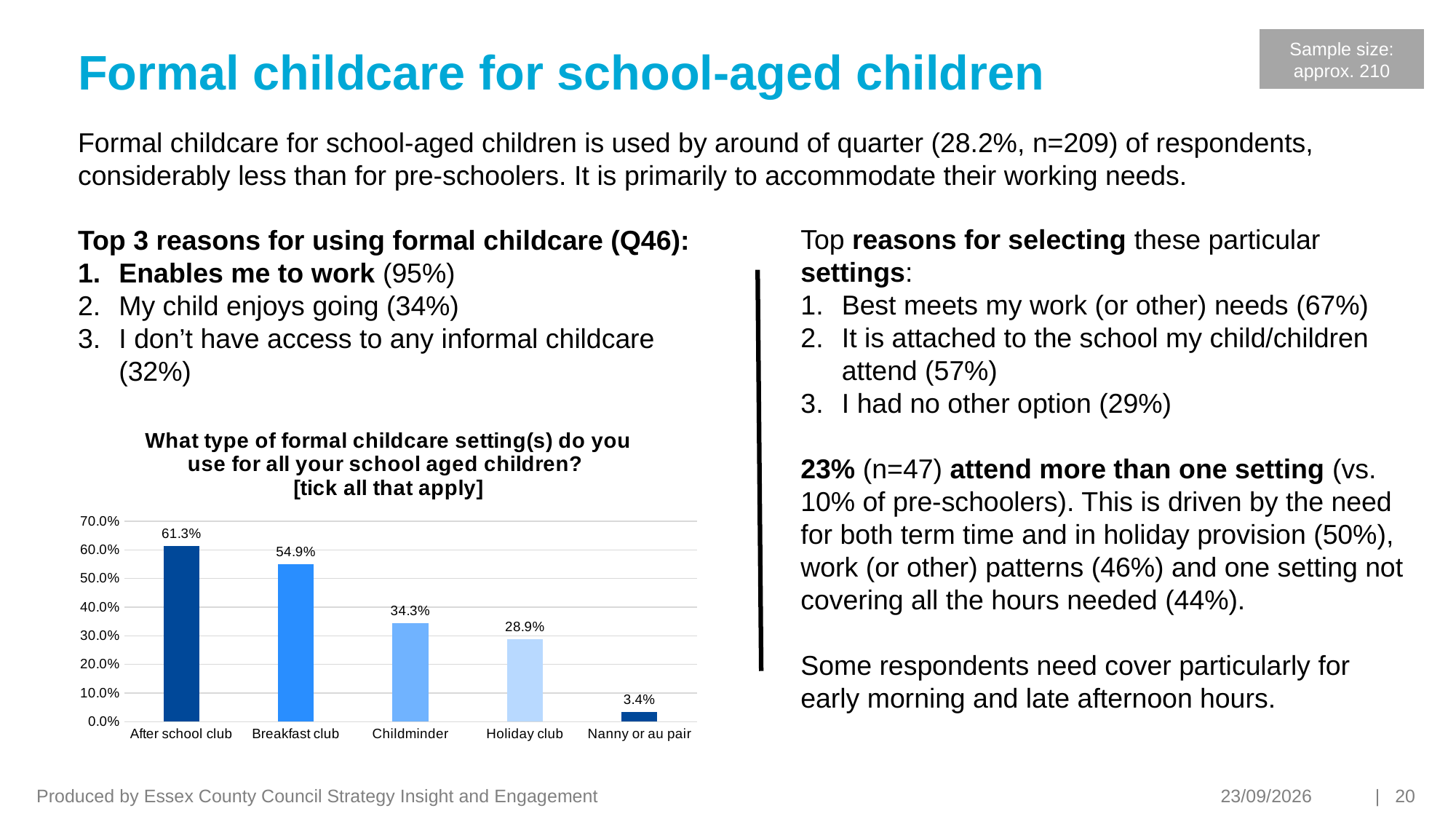
How many childcare setting categories are shown in the chart? 5 Which childcare setting has the lowest percentage? Nanny or au pair What is the maximum value shown on the chart's vertical axis? 70.0% What percentage is shown for Nanny or au pair? 3.4% Which childcare setting has the highest percentage? After school club What percentage of respondents use an after school club? 61.3% Do the values rise or fall moving from left to right across the categories? Fall What is the difference in percentage points between After school club and Breakfast club? 6.4 Which is larger, the value for Childminder or the value for Holiday club? Childminder What kind of chart is used to show the types of formal childcare settings? Bar chart Is the value for Holiday club greater or less than 30.0%? less What is the value shown for Childminder? 34.3%